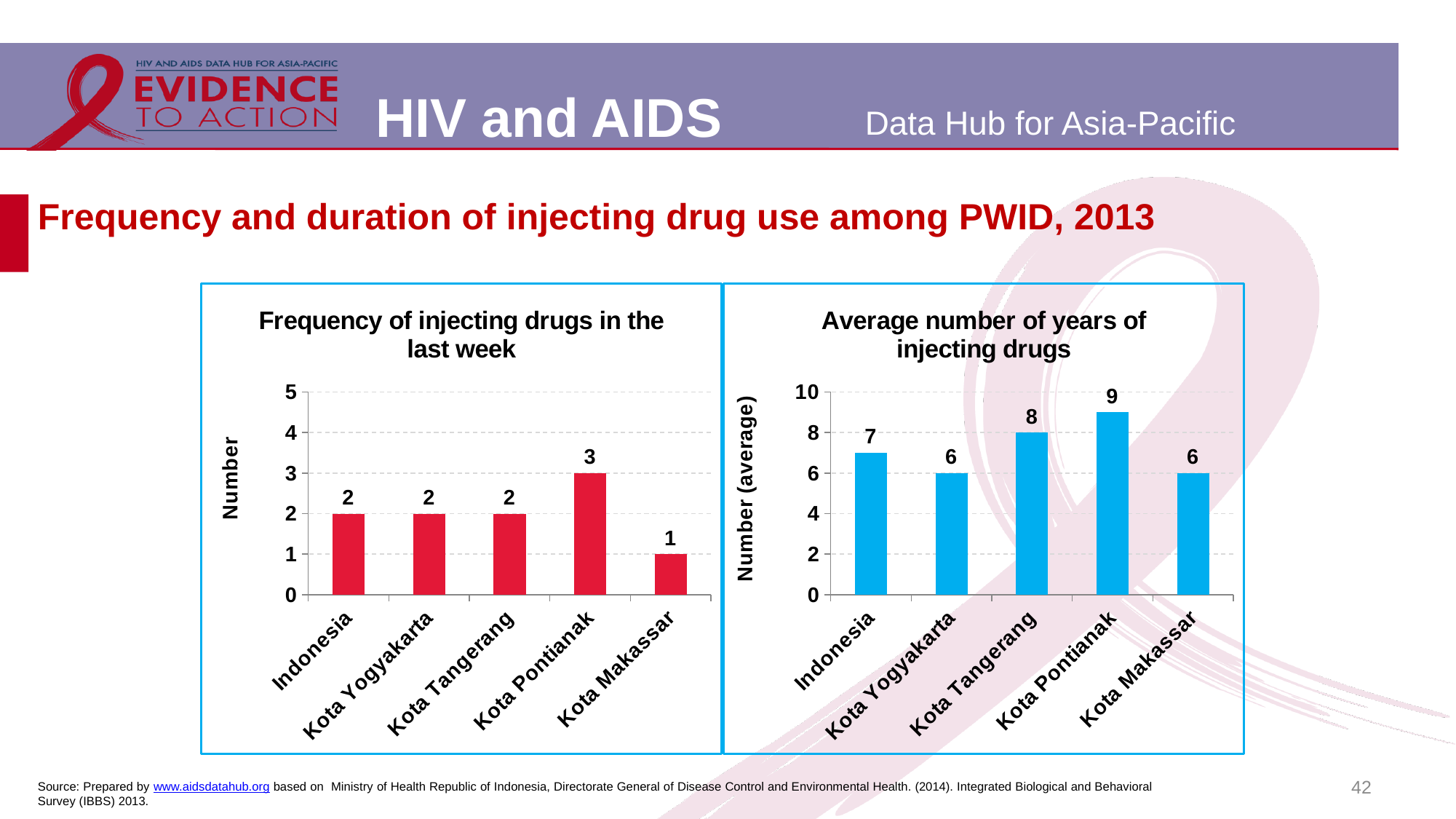
In the 'Average number of years of injecting drugs' chart, what is the value for Indonesia? 7 In the 'Average number of years of injecting drugs' chart, what is the value for Kota Tangerang? 8 In the 'Average number of years of injecting drugs' chart, which is larger, Kota Yogyakarta or Kota Tangerang? Kota Tangerang In the 'Frequency of injecting drugs in the last week' chart, what is the difference between Kota Pontianak and Kota Makassar? 2 What type of chart is the 'Average number of years of injecting drugs' chart? Bar chart In the 'Frequency of injecting drugs in the last week' chart, what is the value for Kota Makassar? 1 In the 'Frequency of injecting drugs in the last week' chart, which category has the lowest value? Kota Makassar In the 'Frequency of injecting drugs in the last week' chart, which category has the highest value? Kota Pontianak In the 'Average number of years of injecting drugs' chart, what is the difference between Kota Pontianak and Kota Yogyakarta? 3 In the 'Frequency of injecting drugs in the last week' chart, what is the value for Kota Pontianak? 3 In the 'Average number of years of injecting drugs' chart, which category has the highest value? Kota Pontianak How many categories are shown in the 'Frequency of injecting drugs in the last week' chart? 5